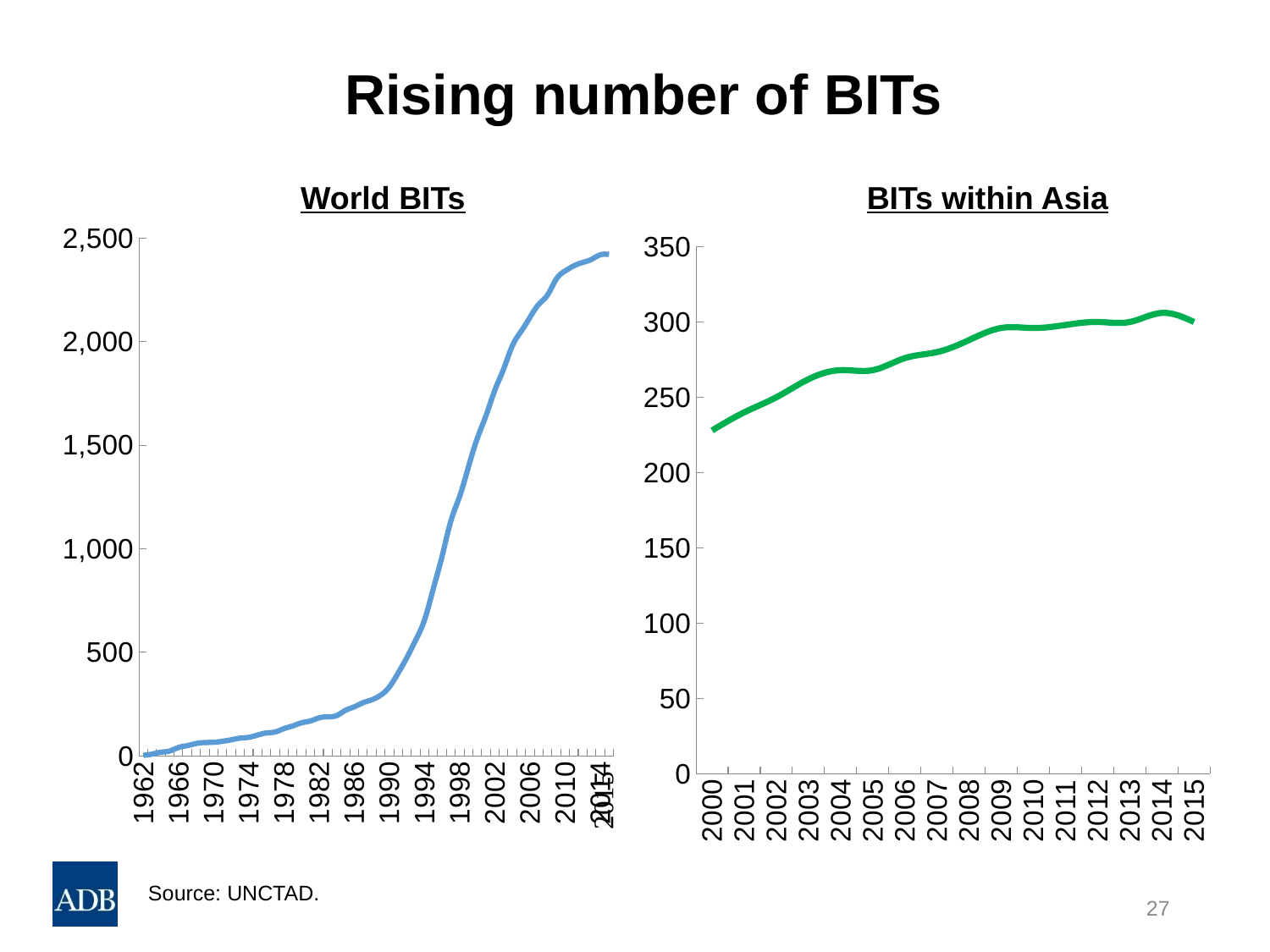
In the BITs within Asia chart, which year has the lowest value? 2000 In the World BITs chart, do the values rise or fall from 1962 to 2015? rise In the BITs within Asia chart, is the value for 2008 greater or less than 300? less In the BITs within Asia chart, how many years are labelled on the x axis? 16 In the BITs within Asia chart, is the value for 2005 greater or less than 250? greater What type of chart is the World BITs chart? line chart In the World BITs chart, is the value for 1998 greater or less than 1,000? greater In the BITs within Asia chart, which is larger, the value for 2015 or the value for 2000? 2015 In the World BITs chart, which year has the lowest value? 1962